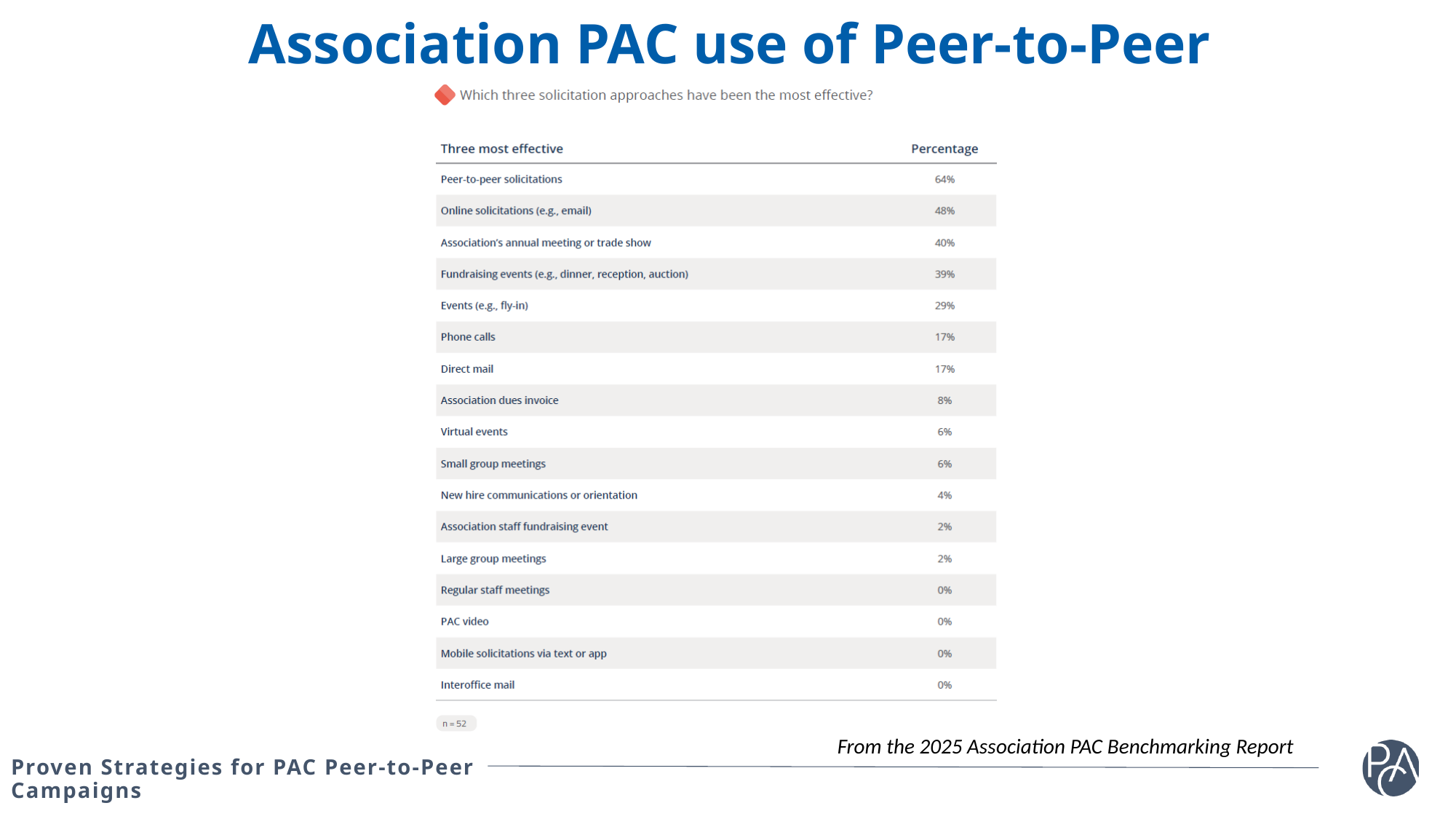
How many solicitation approaches are listed in the table? 17 In the table, what percentage is shown for Peer-to-peer solicitations? 64% What is the difference in percentage points between Association's annual meeting or trade show and Fundraising events (e.g., dinner, reception, auction)? 1 What survey question is shown above the table? Which three solicitation approaches have been the most effective? In the table, what percentage is shown for Events (e.g., fly-in)? 29% In the table, what percentage is shown for Online solicitations (e.g., email)? 48% How many approaches in the table show a percentage of 0%? 4 What is the sample size (n) shown below the table? n = 52 Which has a higher percentage: Phone calls or Virtual events? Phone calls Which solicitation approach has the highest percentage in the table? Peer-to-peer solicitations What is the difference in percentage points between Peer-to-peer solicitations and Online solicitations (e.g., email)? 16 In the table, what percentage is shown for Association dues invoice? 8%